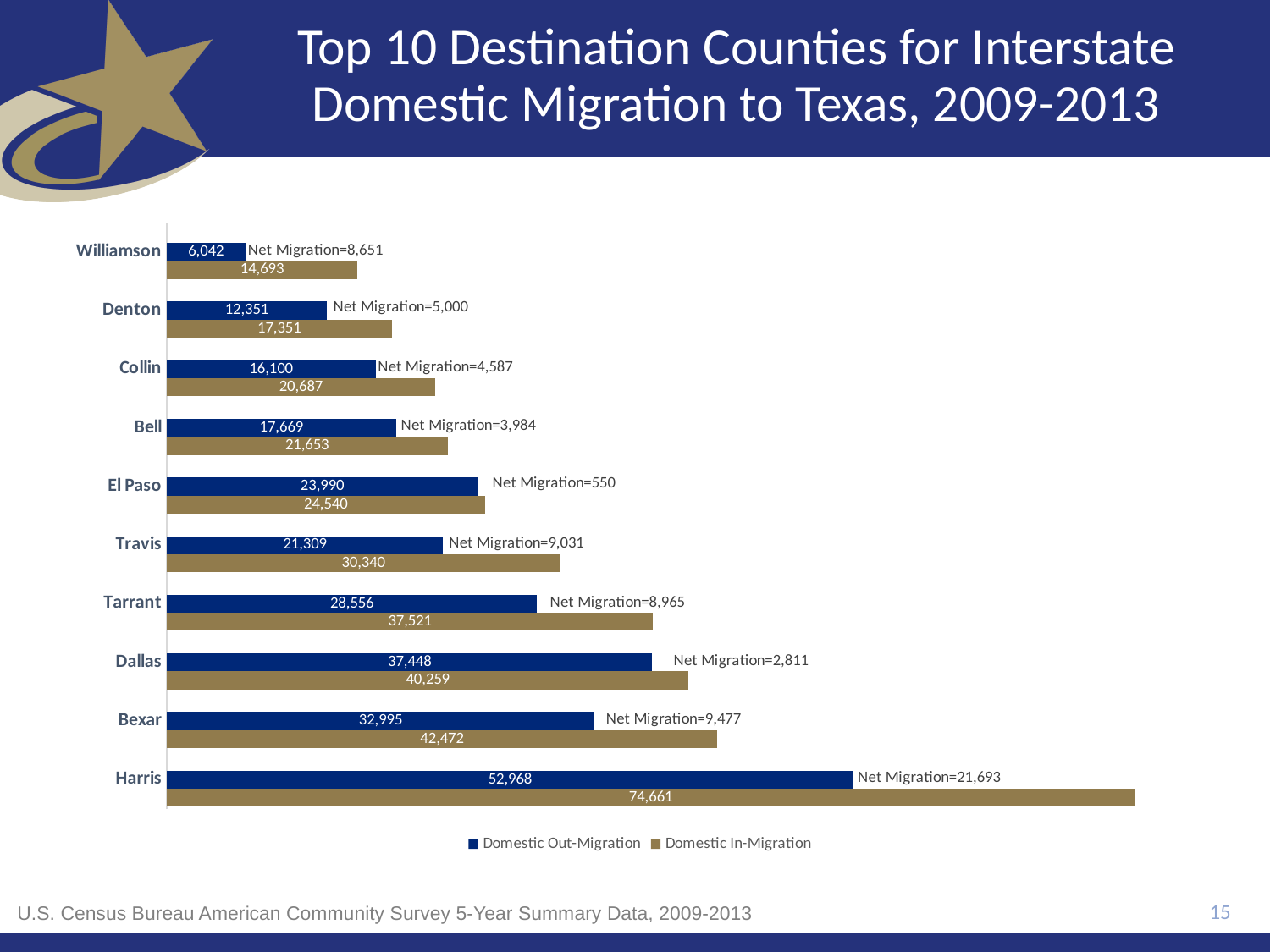
Which county has the lowest Domestic Out-Migration? Williamson What kind of chart is shown on the slide? Bar chart What is the Domestic In-Migration value for Harris? 74,661 Which county has the highest Domestic In-Migration? Harris How many series does the legend list? 2 What is the difference between Domestic In-Migration and Domestic Out-Migration for Dallas? 2,811 Which colour represents Domestic In-Migration in the legend? Gold/tan How many counties are shown in the chart? 10 What is the Net Migration value shown for Bexar? 9,477 What is the Domestic Out-Migration value for Travis? 21,309 Which county has the smallest Net Migration value? El Paso Which is larger, the Domestic In-Migration for Tarrant or the Domestic In-Migration for Travis? Tarrant